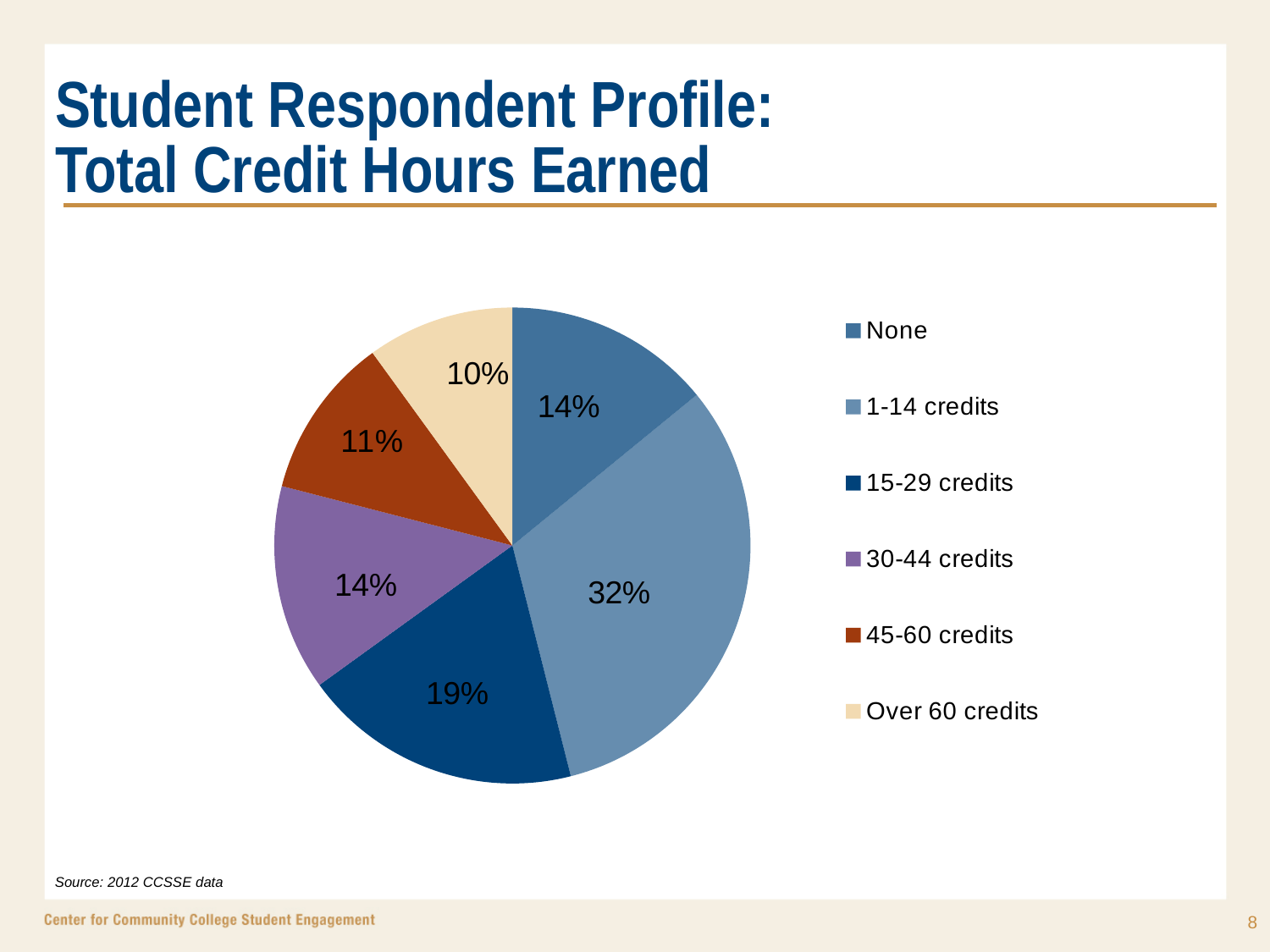
What share of respondents have earned over 60 credits? 10% Which credit-hour category has the smallest share of respondents? Over 60 credits What share of respondents have earned 45-60 credits? 11% How many categories does the pie chart have? 6 Which is larger, the share for 15-29 credits or the share for 30-44 credits? 15-29 credits What kind of chart is shown on the slide? pie chart Which credit-hour category has the largest share of respondents? 1-14 credits What is the title of the slide containing the chart? Student Respondent Profile: Total Credit Hours Earned What share of respondents have earned no credits (None)? 14% What is the difference in percentage points between the 1-14 credits share and the 15-29 credits share? 13 What share of respondents have earned 15-29 credits? 19% What share of respondents have earned 1-14 credits? 32%